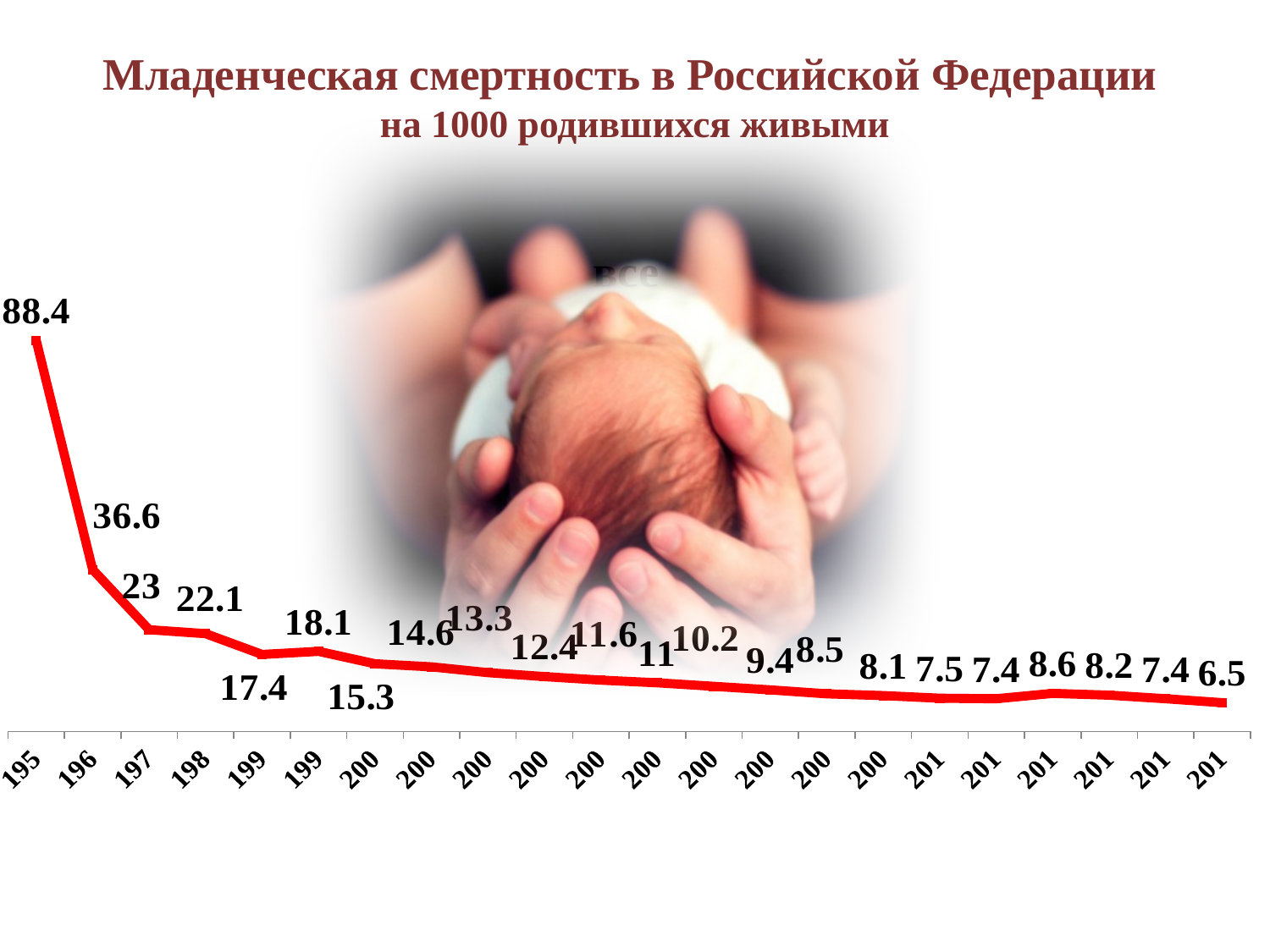
What kind of chart is shown on the slide? line chart What is the highest value plotted on the chart? 88.4 What is the lowest value plotted on the chart? 6.5 What is the value of the last (rightmost) point on the line? 6.5 How many data points are plotted on the line? 22 What is the difference between the first point (88.4) and the last point (6.5) on the line? 81.9 What is the value of the first (leftmost) point on the line? 88.4 Do the values generally rise or fall from left to right along the x axis? fall What colour is the plotted line? red What is the title of the chart? Младенческая смертность в Российской Федерации на 1000 родившихся живыми What is the value of the second point from the left on the line? 36.6 Which is larger, the value of the first point on the line or the value of the second point? the first point (88.4)